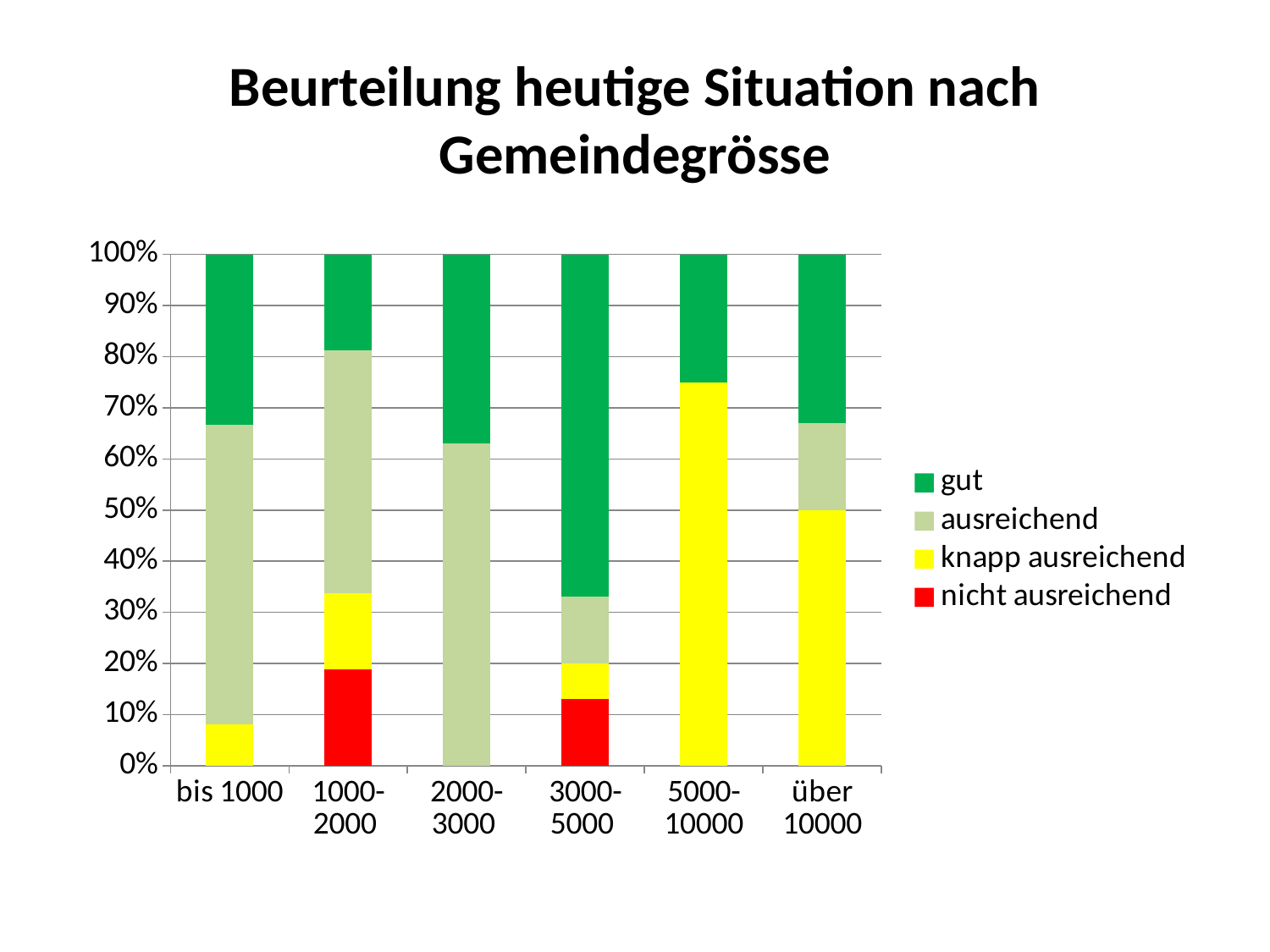
Is the 'knapp ausreichend' share for '5000-10000' greater or less than 70%? greater Which category has the larger 'nicht ausreichend' share, '1000-2000' or '3000-5000'? 1000-2000 What is the title of the chart? Beurteilung heutige Situation nach Gemeindegrösse How many series does the legend list? 4 What kind of chart is shown on the slide? Stacked bar chart Is the 'nicht ausreichend' share for '1000-2000' greater or less than 10%? greater What is the share of 'knapp ausreichend' for 'über 10000'? 50% What is the total of the stacked bar for 'bis 1000'? 100% Which category has the largest 'knapp ausreichend' share? 5000-10000 How many municipality size categories are shown on the x axis? 6 Which category has the largest 'gut' share? 3000-5000 Which legend entry is shown in red? nicht ausreichend